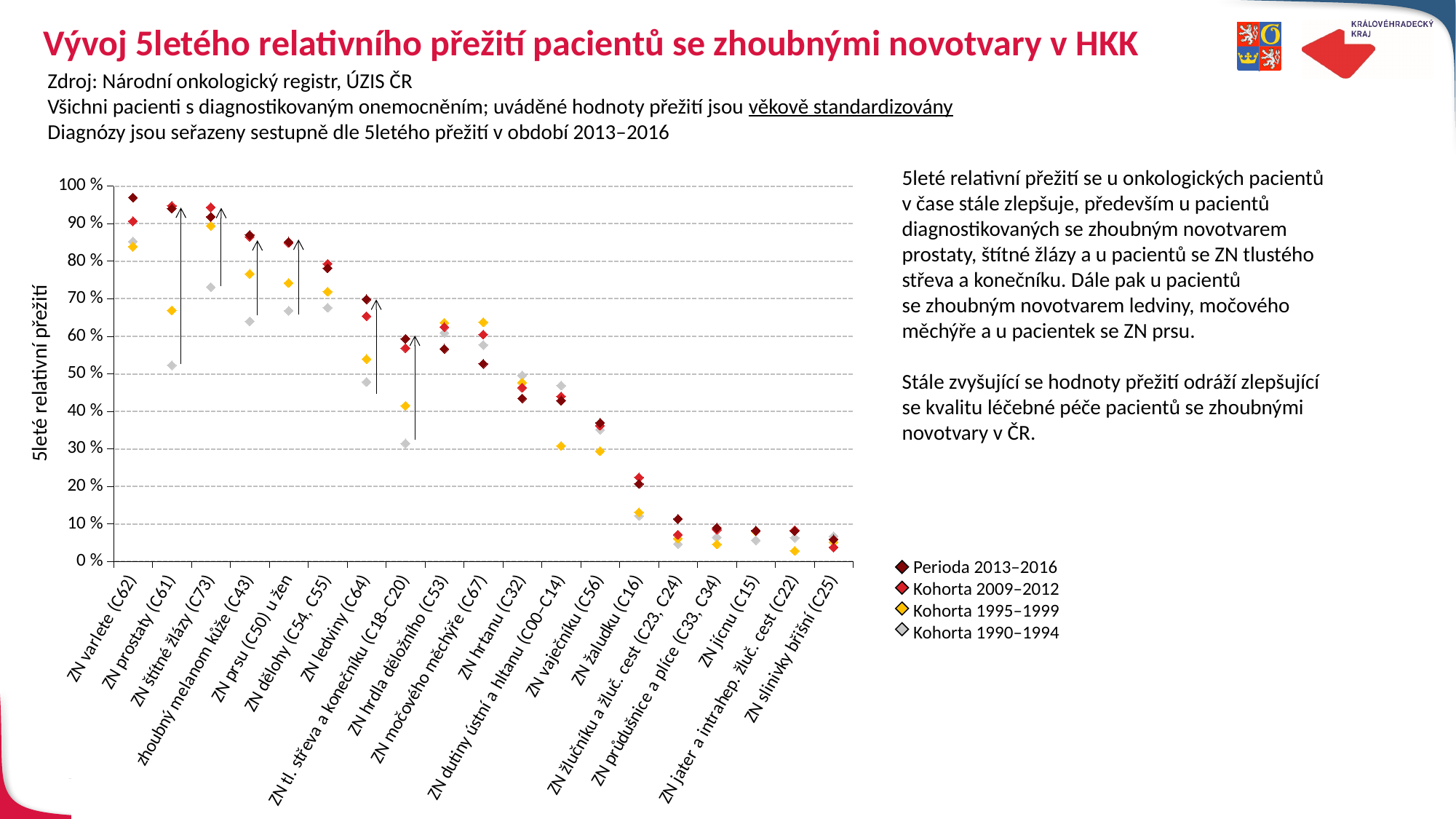
Which diagnosis has the highest value for Perioda 2013–2016? ZN varlete (C62) Which diagnosis has the highest value for Kohorta 1990–1994? ZN varlete (C62) Do the Perioda 2013–2016 values generally rise or fall from left to right along the x axis? fall Is the Kohorta 1990–1994 value for ZN tl. střeva a konečníku (C18–C20) greater or less than 20 %? greater What is the label of the y axis? 5leté relativní přežití For ZN prostaty (C61), which is larger: the Perioda 2013–2016 value or the Kohorta 1990–1994 value? Perioda 2013–2016 Is the Perioda 2013–2016 value for ZN varlete (C62) greater or less than 90 %? greater How many series does the legend list? 4 How many diagnosis categories are plotted along the x axis? 19 Is the Kohorta 1990–1994 value for ZN prostaty (C61) greater or less than 60 %? less What kind of chart is shown on the slide? Scatter (dot) chart